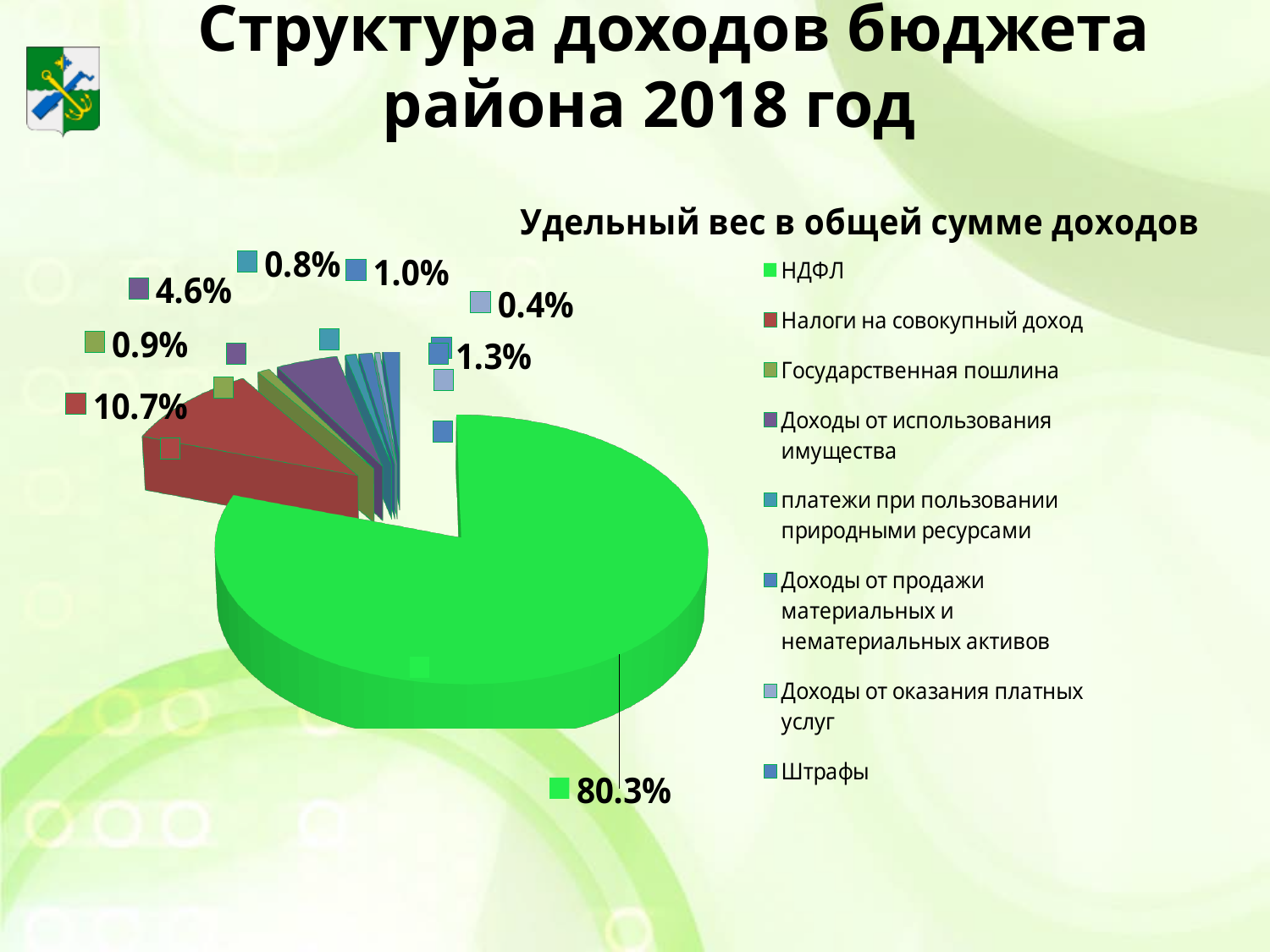
What is the value for Налоги на совокупный доход? 10.7% Which category has the smallest share of the pie? Доходы от оказания платных услуг Which is larger: the share of Доходы от использования имущества or the share of Государственная пошлина? Доходы от использования имущества What is the value for Государственная пошлина? 0.9% What is the title of the chart? Удельный вес в общей сумме доходов What type of chart is shown on the slide? Pie chart What is the value for Доходы от использования имущества? 4.6% Which category has the largest share of the pie? НДФЛ What share of total income does НДФЛ account for? 80.3% How many categories does the legend of the pie chart list? 8 What is the difference between the shares of НДФЛ and Налоги на совокупный доход? 69.6 percentage points What is the value for платежи при пользовании природными ресурсами? 0.8%